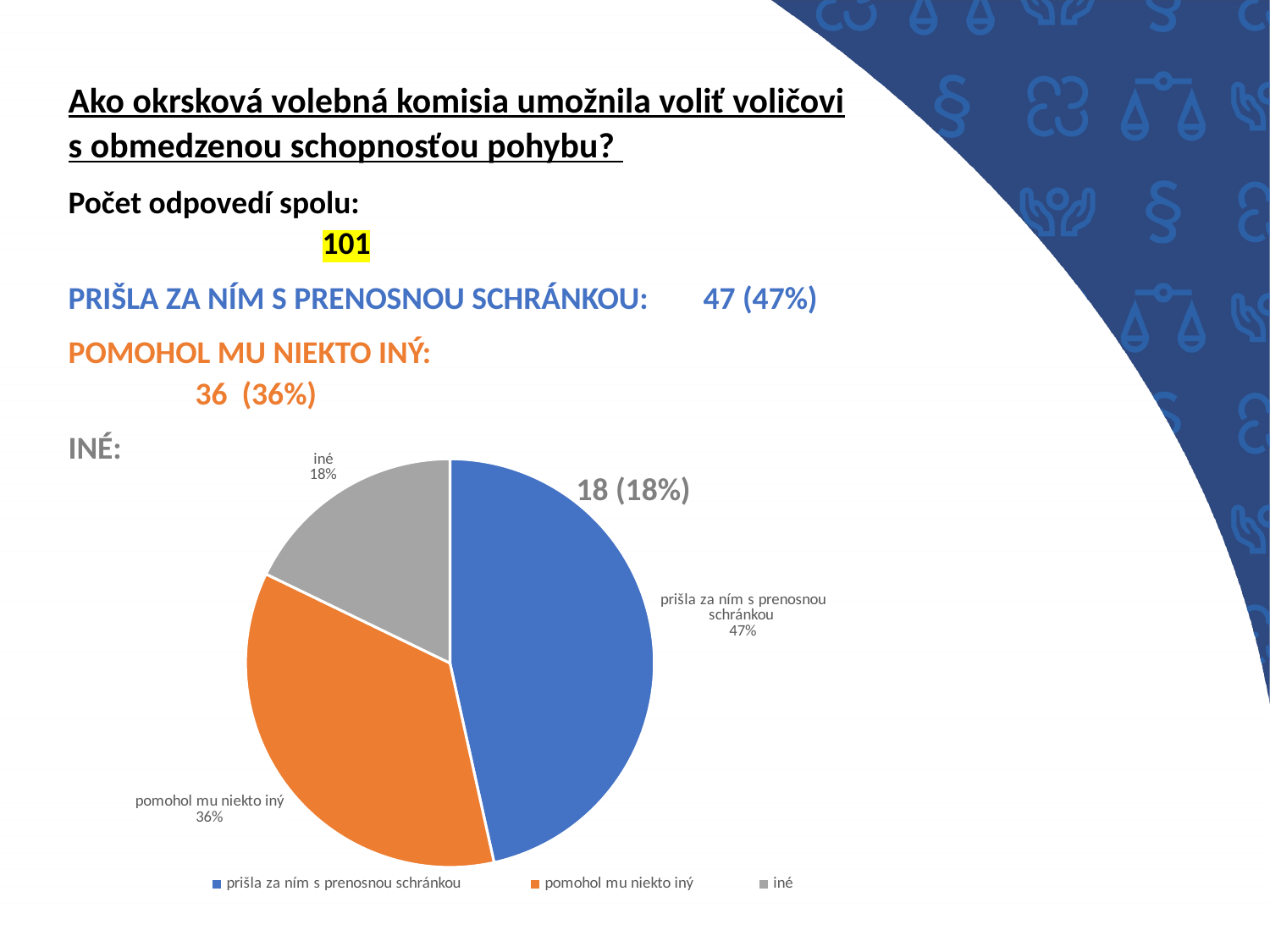
What percentage is shown for the slice "pomohol mu niekto iný" in the pie chart? 36% What colour is the "iné" slice in the pie chart? grey What is the difference in percentage points between the "pomohol mu niekto iný" slice and the "iné" slice? 18 How many entries does the legend of the pie chart list? 3 Which slice is larger in the pie chart: "pomohol mu niekto iný" or "iné"? pomohol mu niekto iný What percentage of the pie chart does the slice "prišla za ním s prenosnou schránkou" represent? 47% How many slices does the pie chart have? 3 What percentage is shown for the slice "iné" in the pie chart? 18% What type of chart is shown on the slide? pie chart Which slice of the pie chart is the smallest? iné Which slice of the pie chart is the largest? prišla za ním s prenosnou schránkou What is the difference in percentage points between the "prišla za ním s prenosnou schránkou" slice and the "pomohol mu niekto iný" slice? 11